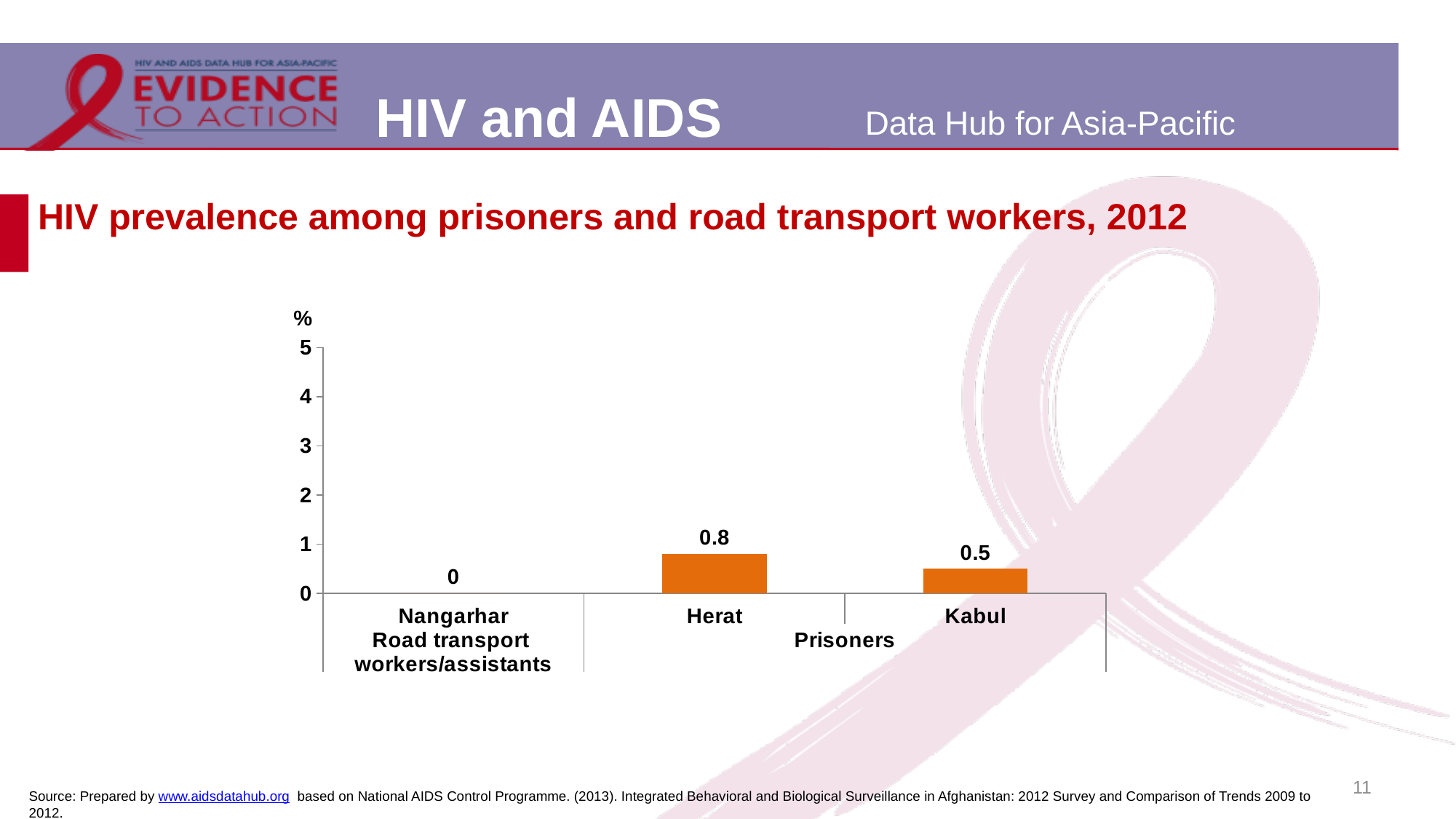
Which group do the Herat and Kabul bars belong to? Prisoners Which has a larger value, Herat or Kabul? Herat What is the HIV prevalence value shown for Herat? 0.8 Which category has the lowest HIV prevalence value? Nangarhar What is the HIV prevalence value shown for Nangarhar? 0 What kind of chart is shown on the slide? bar chart Is the value for Herat greater or less than 1? less Which category has the highest HIV prevalence value? Herat How many categories are shown on the x axis? 3 What is the HIV prevalence value shown for Kabul? 0.5 What is the difference between the values for Herat and Kabul? 0.3 What is the title of the chart? HIV prevalence among prisoners and road transport workers, 2012